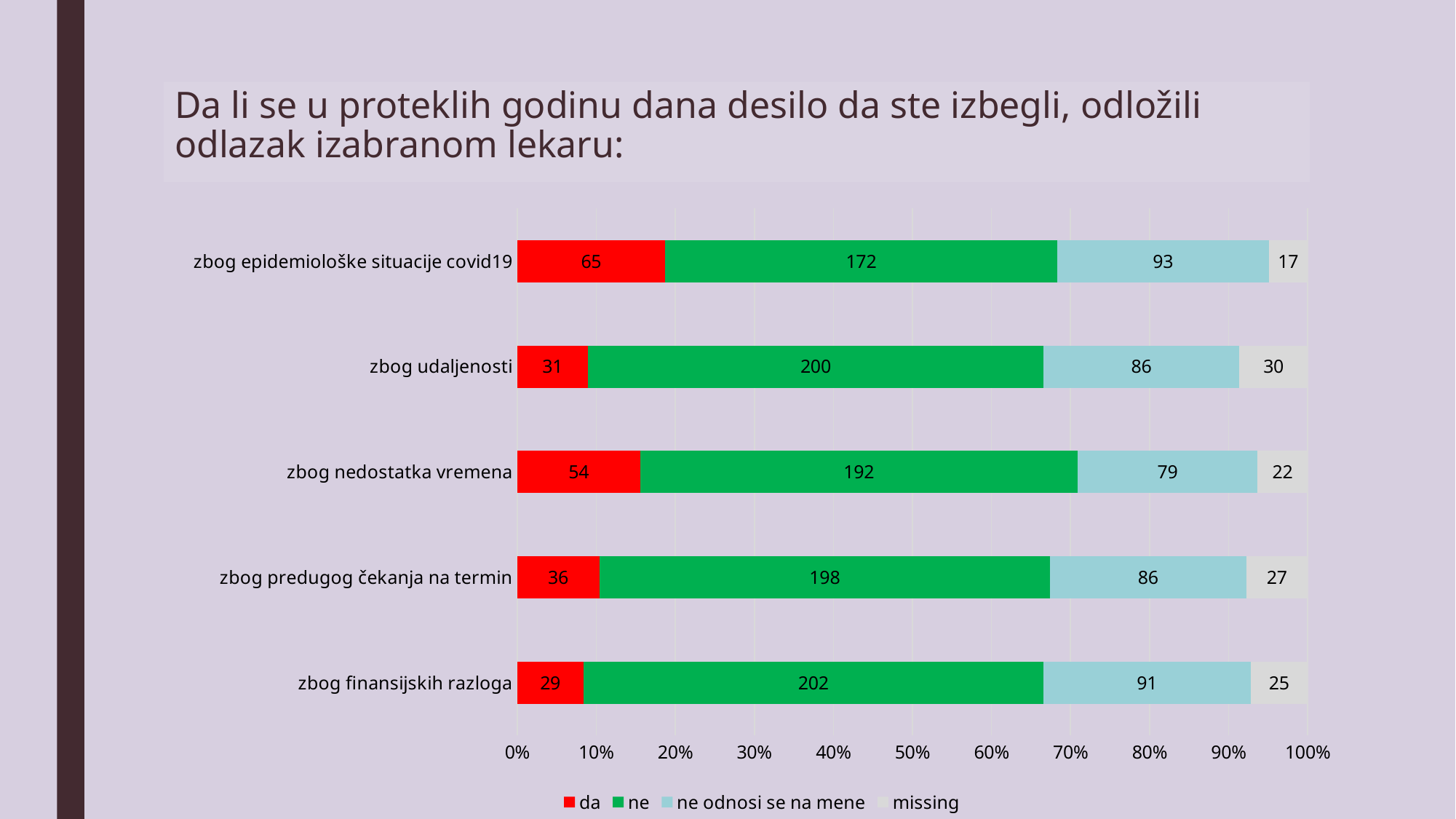
Which category has the highest value for the "da" series? zbog epidemiološke situacije covid19 Which category has the lowest value for the "da" series? zbog finansijskih razloga What is the value of the "da" series for "zbog epidemiološke situacije covid19"? 65 What is the value of the "missing" series for "zbog predugog čekanja na termin"? 27 What kind of chart is shown on the slide? stacked bar chart What is the difference between the "ne" values for "zbog finansijskih razloga" and "zbog epidemiološke situacije covid19"? 30 What is the total of all segments in the bar for "zbog udaljenosti"? 347 What is the value of the "ne odnosi se na mene" series for "zbog finansijskih razloga"? 91 How many series does the legend list? 4 Which is larger: the "da" value for "zbog nedostatka vremena" or for "zbog predugog čekanja na termin"? zbog nedostatka vremena What is the value of the "ne" series for "zbog udaljenosti"? 200 How many categories are shown on the chart? 5